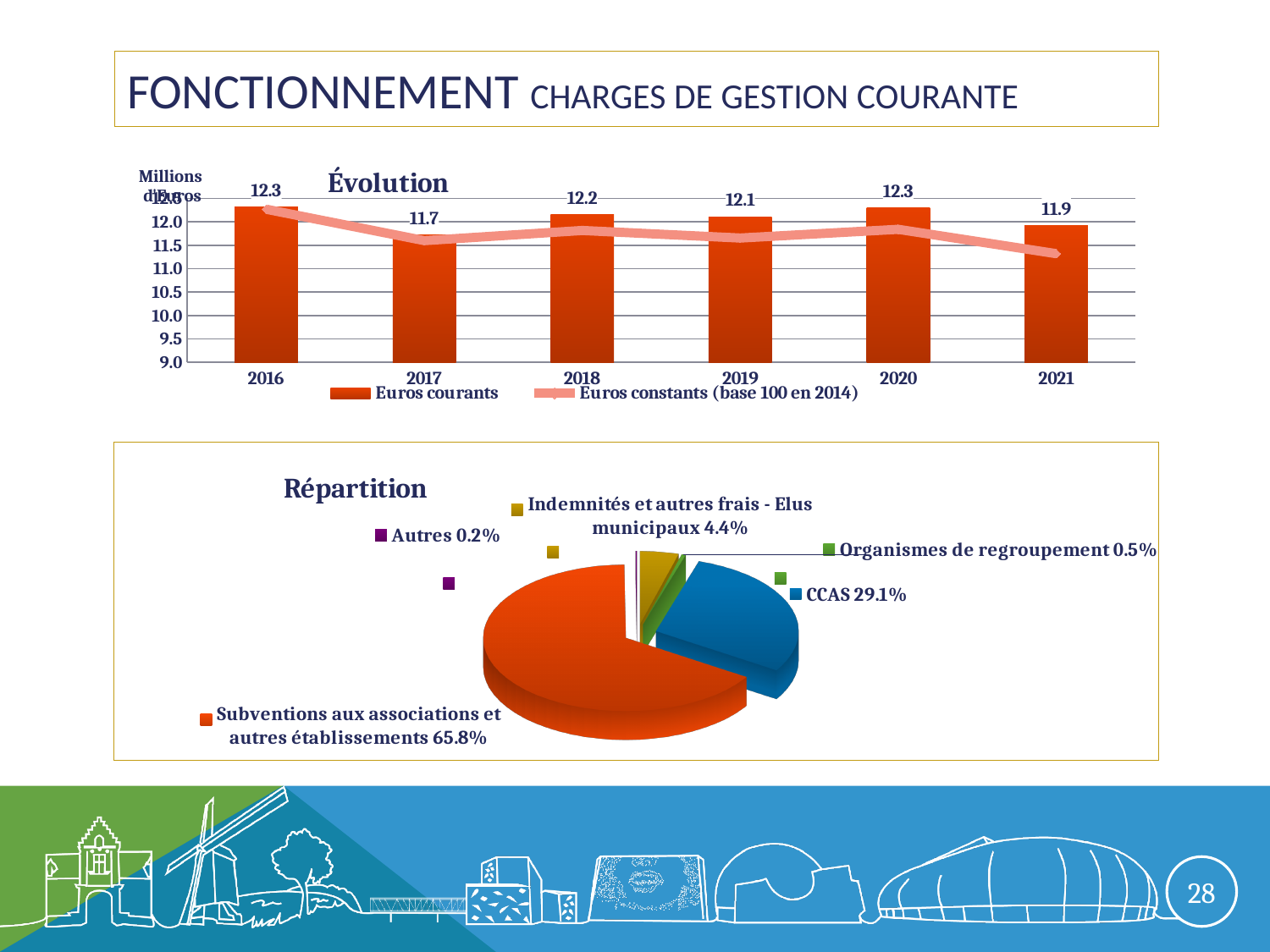
In the Évolution chart, what is the difference between the Euros courants values for 2016 and 2017? 0.6 In the Répartition chart, what share does CCAS have? 29.1% In the Évolution chart, which year has the larger Euros courants value, 2018 or 2021? 2018 In the Évolution chart, which year has the lowest Euros courants value? 2017 In the Répartition chart, which category has the largest share? Subventions aux associations et autres établissements How many years are shown on the x axis of the Évolution chart? 6 In the Évolution chart, what is the Euros courants value for 2017? 11.7 How many series does the legend of the Évolution chart list? 2 What kind of chart is the Répartition chart? Pie chart In the Évolution chart, is the Euros constants value for 2017 greater or less than 11.0? greater In the Évolution chart, what is the Euros courants value for 2021? 11.9 In the Répartition chart, which category has the smallest share? Autres